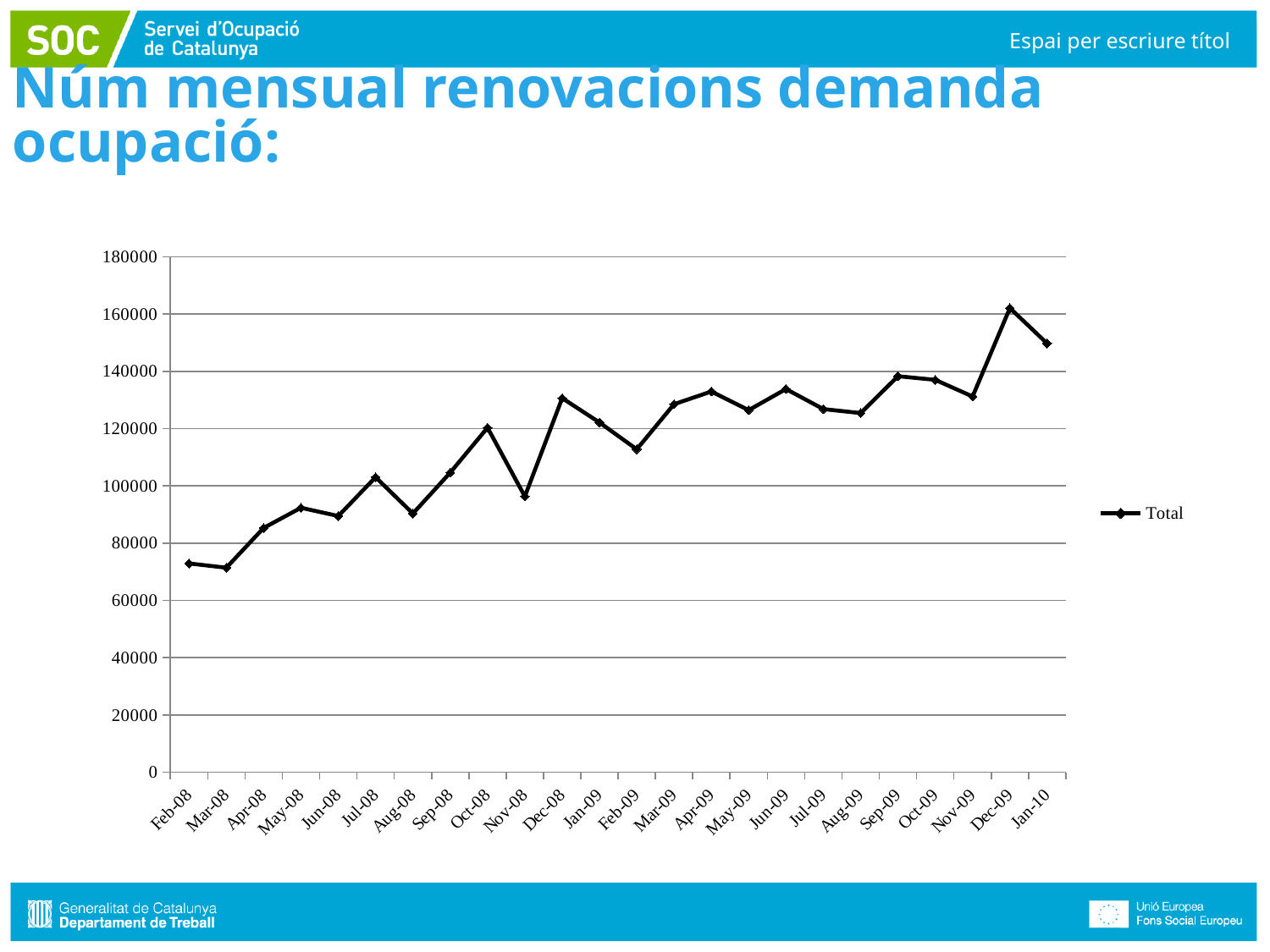
What is the name of the series shown in the legend? Total What kind of chart is shown on the slide? line chart Is the value for Feb-08 greater or less than 80000? less Which is larger, the value for Dec-08 or the value for Nov-08? Dec-08 How many monthly data points are plotted on the chart? 24 How many series does the legend list? 1 Is the value for Nov-08 greater or less than 100000? less Which month has the highest value for Total? Dec-09 Is the value for Jan-10 greater or less than 140000? greater Which is larger, the value for Sep-09 or the value for Aug-09? Sep-09 Overall, do the values rise or fall from Feb-08 to Jan-10? rise